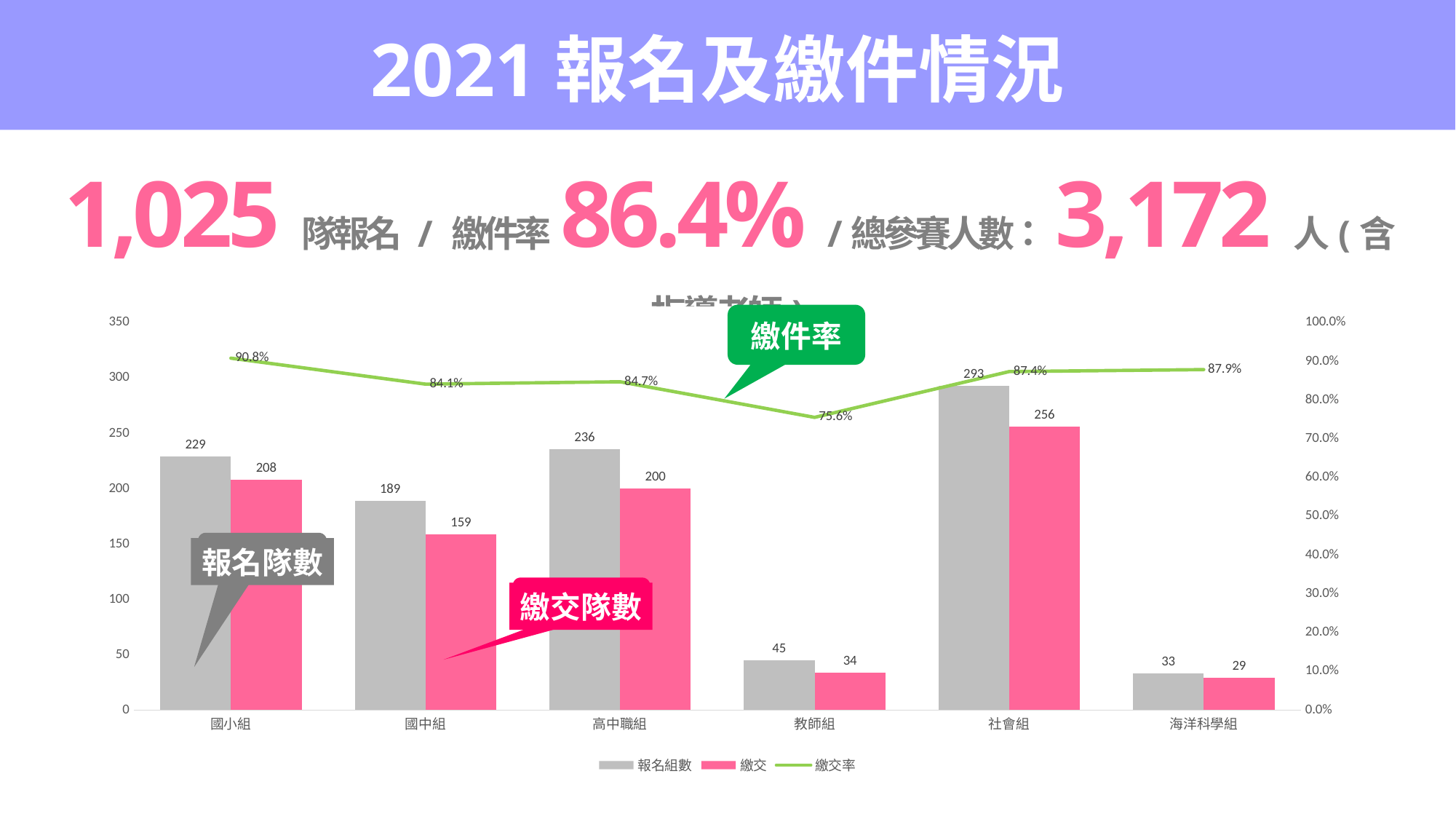
What is the difference between 報名組數 and 繳交 for 高中職組? 36 What is the 報名組數 value for 社會組? 293 What is the 繳交率 for 教師組? 75.6% What is the 繳交率 for 海洋科學組? 87.9% What colour are the 繳交 bars? Pink Which category has the highest 報名組數? 社會組 How many series does the legend list? 3 What kind of chart is this? Combined bar and line chart Which is larger, the 繳交 value for 國小組 or for 高中職組? 國小組 What is the 繳交 value for 國中組? 159 How many categories are shown on the x axis? 6 Which category has the lowest 繳交率? 教師組